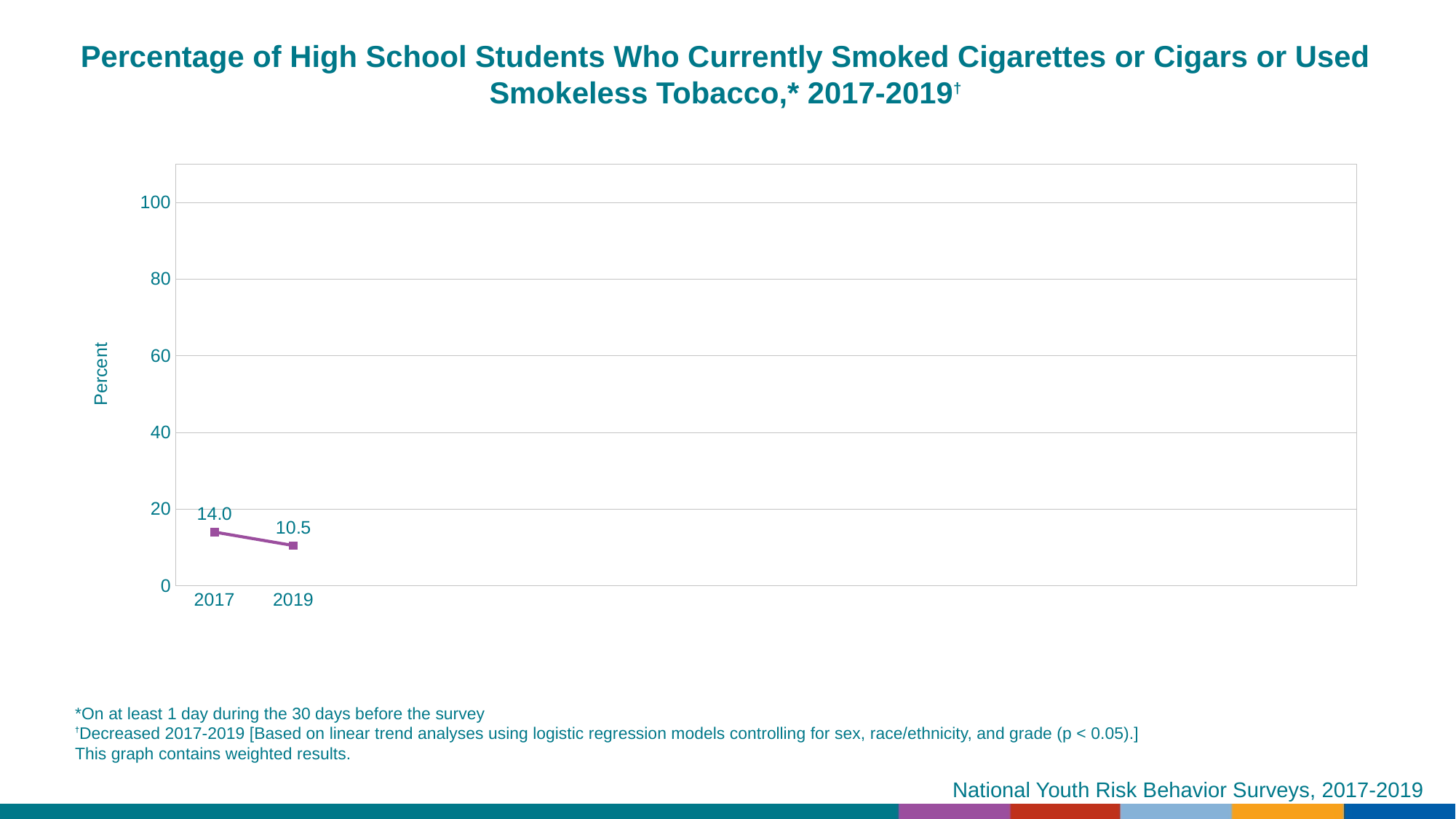
What is the difference between the values for 2017 and 2019? 3.5 Which year has the highest value? 2017 What kind of chart is shown on the slide? line chart What is the label of the y axis? Percent What is the value for 2017? 14.0 What is the highest value shown on the y axis? 100 What is the value for 2019? 10.5 How many data points are plotted on the chart? 2 Is the value for 2017 greater or less than 20? less Which year has the lowest value? 2019 Which is larger, the value for 2017 or the value for 2019? 2017 Do the values rise or fall from 2017 to 2019? fall